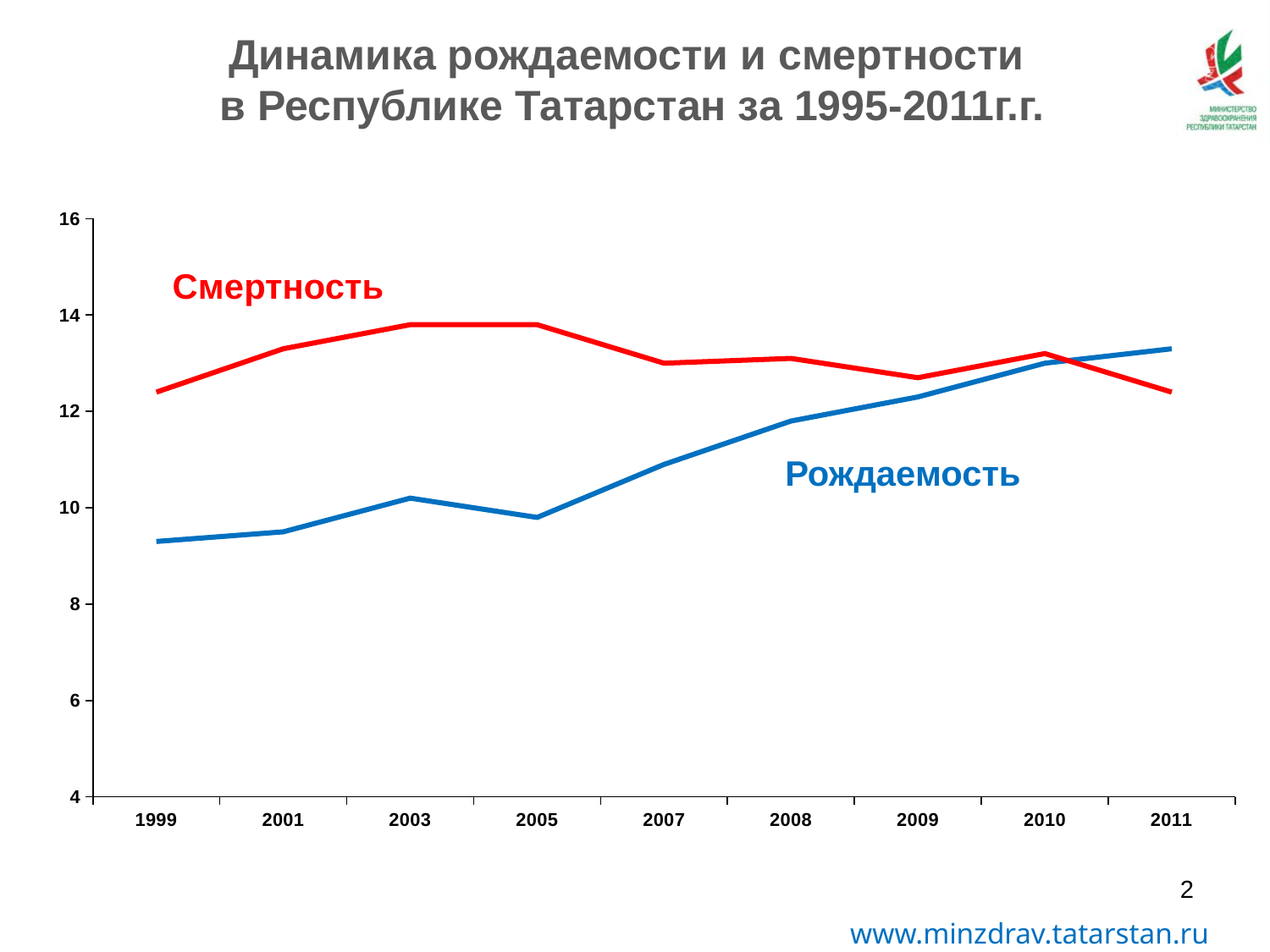
How many years are shown on the x axis of the chart? 9 In 2011, which series has the higher value, Смертность or Рождаемость? Рождаемость Does Рождаемость rise or fall from 2005 to 2011? rise In which year is Рождаемость at its lowest? 1999 In 1999, which series has the higher value, Смертность or Рождаемость? Смертность How many series are plotted on the chart? 2 Is the value for Рождаемость in 2007 greater or less than 10? greater In which year is Рождаемость at its highest? 2011 Is the value for Рождаемость in 2011 greater or less than 12? greater What kind of chart is shown on the slide? line chart Is the value for Рождаемость in 1999 greater or less than 10? less